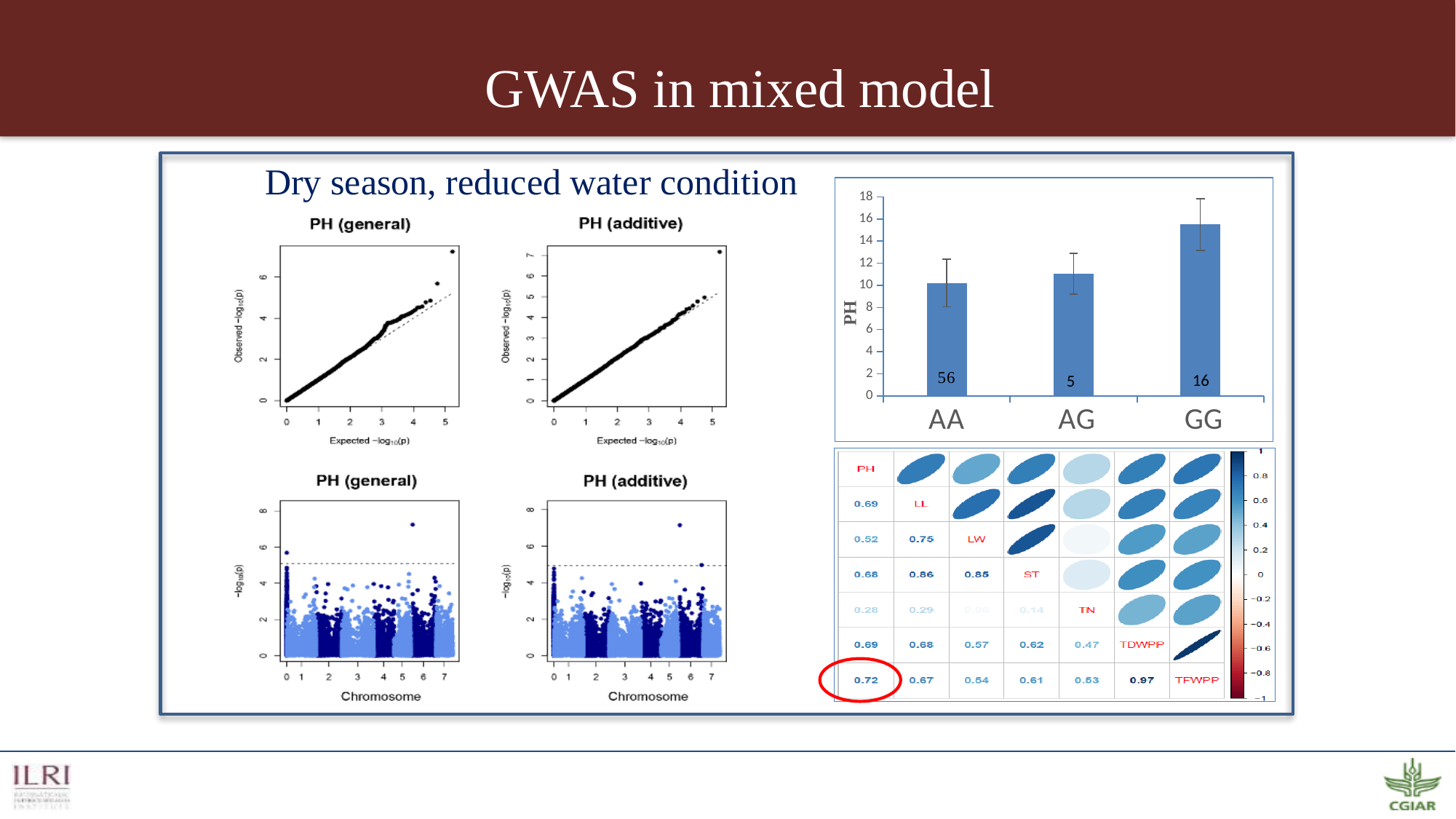
In the bar chart of PH by genotype, is the value for AG greater or less than 12? less In the bar chart of PH by genotype, what number is printed inside the GG bar? 16 What kind of chart is the PH by genotype chart in the upper right? bar chart In the bar chart of PH by genotype, which genotype has the tallest bar? GG What is the title of the two plots in the left column of the panel? PH (general) In the correlation matrix in the lower right, what is the circled correlation value between PH and TFWPP? 0.72 In the bar chart of PH by genotype, what number is printed inside the AA bar? 56 In the bar chart of PH by genotype, which genotype has the shortest bar? AA In the correlation matrix in the lower right, what is the correlation value between TDWPP and TFWPP? 0.97 In the bar chart of PH by genotype, how many genotype categories are shown on the x axis? 3 In the bar chart of PH by genotype, is the value for GG greater or less than 14? greater In the bar chart of PH by genotype, is the value for AA greater or less than 12? less